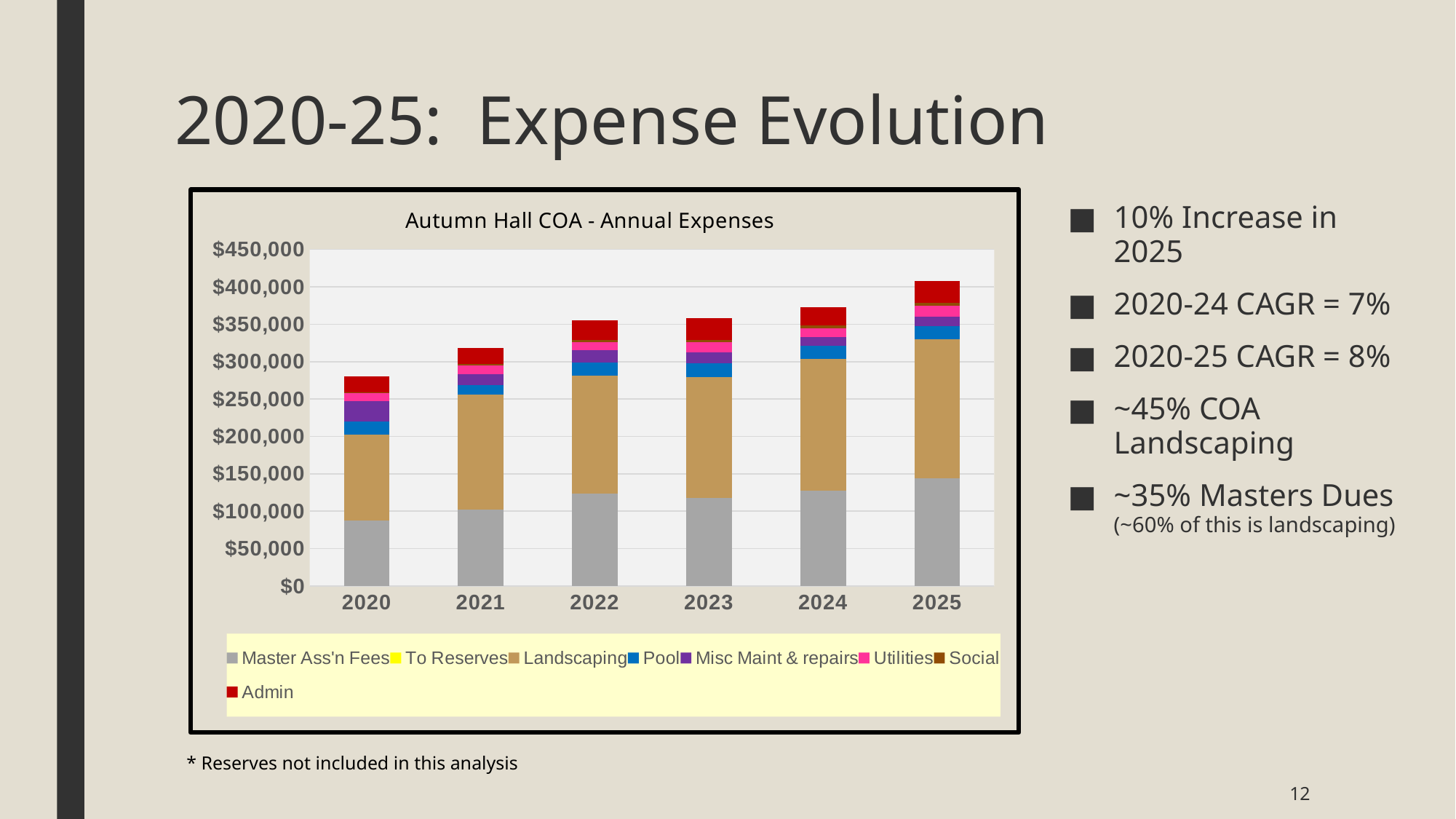
Which series is shown in grey at the bottom of each bar? Master Ass'n Fees Do total annual expenses generally rise or fall from 2020 to 2025? rise Is the total expense for 2020 greater or less than $300,000? less Which year has the lowest total annual expenses? 2020 What is the title of the chart? Autumn Hall COA - Annual Expenses Which year has larger total expenses, 2021 or 2024? 2024 How many years are shown on the x axis of the chart? 6 How many series does the chart's legend list? 8 What kind of chart is shown on the slide? Stacked bar chart Is the total expense for 2025 greater or less than $400,000? greater Which year has the highest total annual expenses? 2025 Is the total expense for 2024 greater or less than $350,000? greater